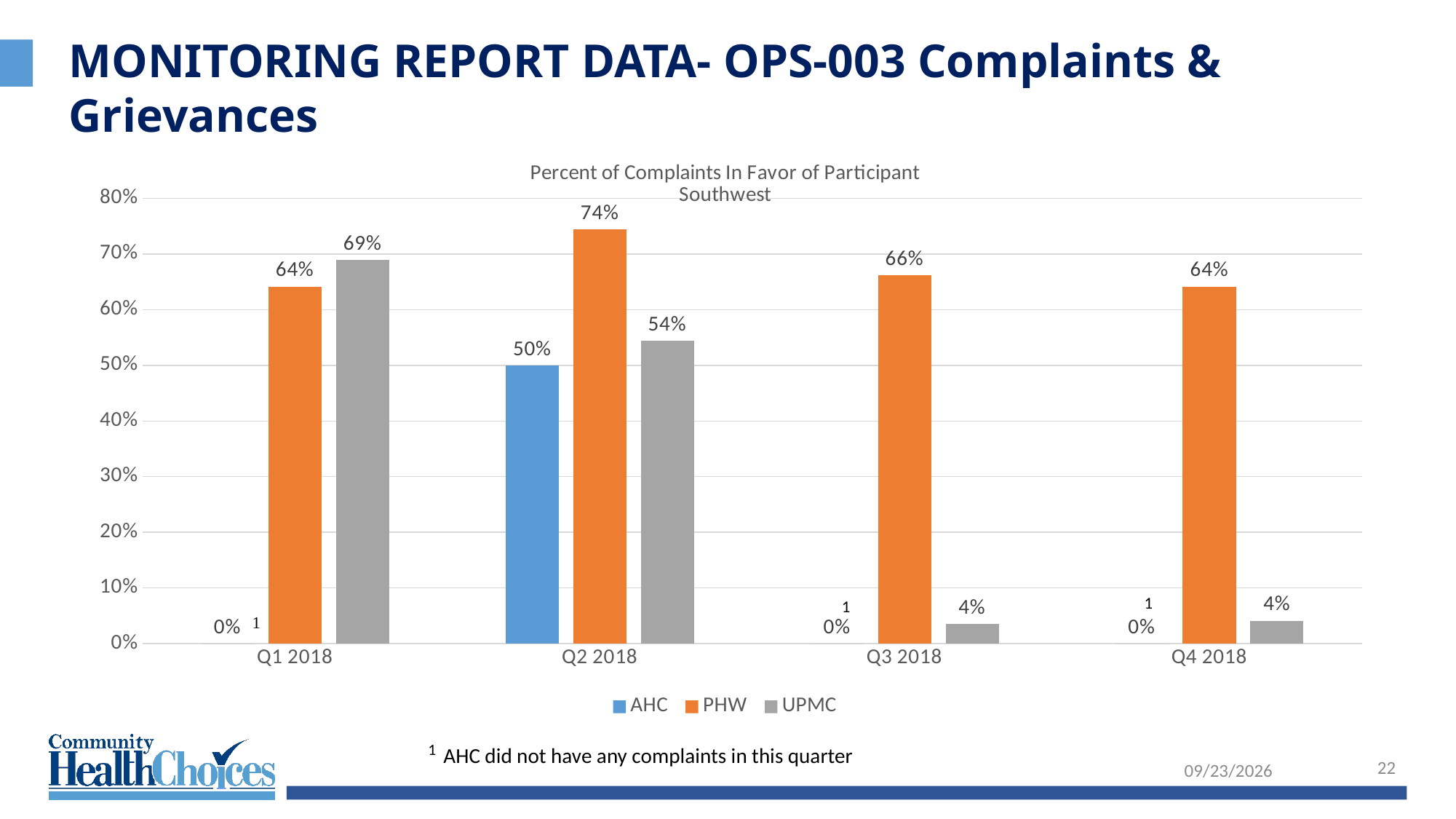
What is the value for UPMC in Q1 2018? 69% In which quarter is the PHW value highest? Q2 2018 What is the value for PHW in Q2 2018? 74% What is the value for UPMC in Q4 2018? 4% Which is larger in Q1 2018, PHW or UPMC? UPMC In which quarter is the UPMC value lowest? Q3 2018 and Q4 2018 What is the difference between the PHW and UPMC values in Q2 2018? 20% How many quarters are shown on the x axis? 4 What kind of chart is shown on the slide? Bar chart What is the value for AHC in Q2 2018? 50% What is the title of the chart? Percent of Complaints In Favor of Participant Southwest How many series does the legend list? 3